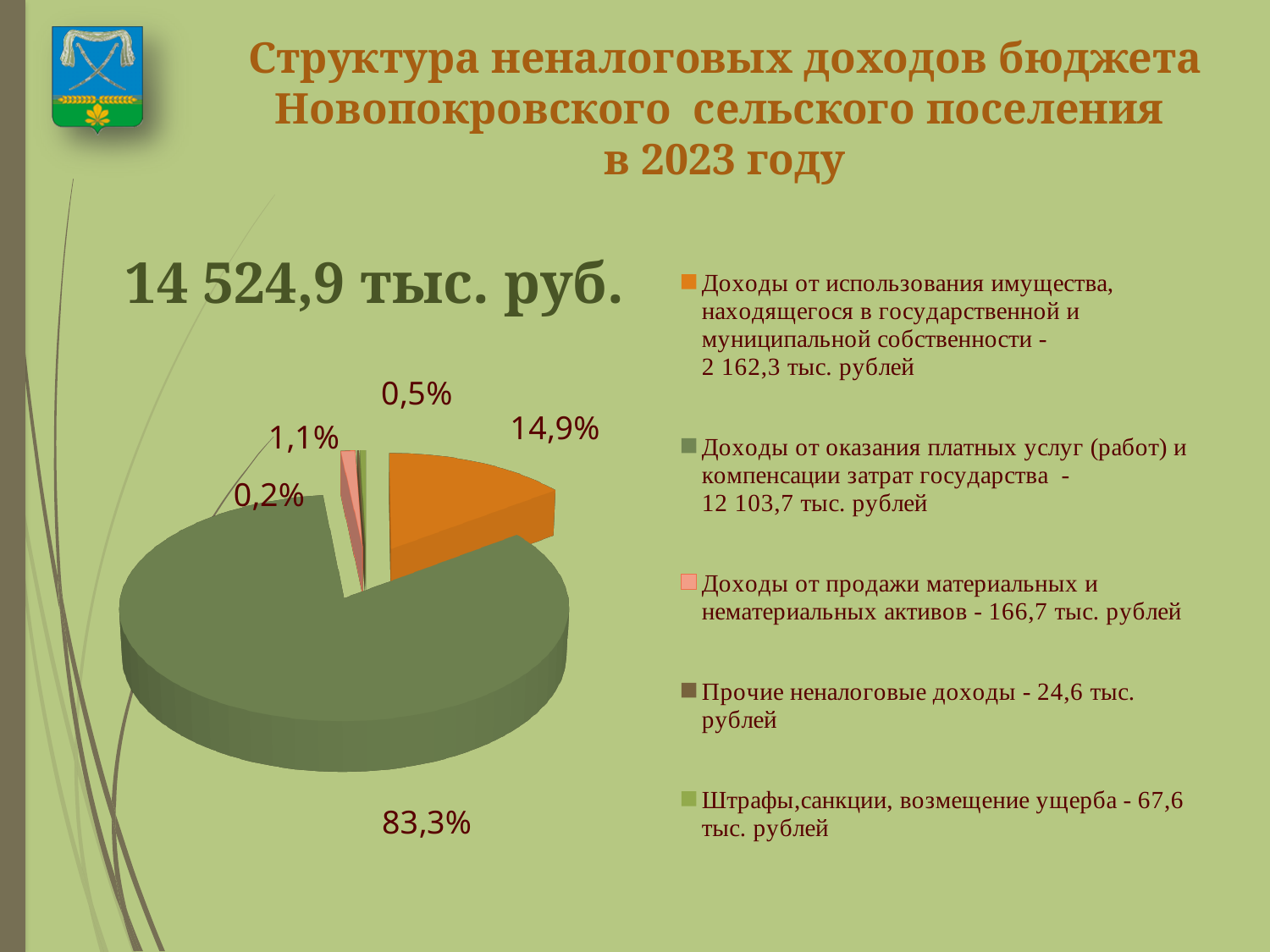
What total amount of non-tax income is shown above the pie chart? 14 524,9 тыс. руб. According to the legend, what is the amount of other non-tax income (Прочие неналоговые доходы)? 24,6 тыс. рублей Which category has the largest slice of the pie? Доходы от оказания платных услуг (работ) и компенсации затрат государства What share of the pie is labelled for fines, sanctions and damage compensation (Штрафы, санкции, возмещение ущерба)? 0,5% How many slices does the pie chart have? 5 What share of the pie is labelled for income from the use of state and municipal property (Доходы от использования имущества)? 14,9% What share of the pie is labelled for income from the sale of tangible and intangible assets (Доходы от продажи материальных и нематериальных активов)? 1,1% Which category has the smallest slice of the pie? Прочие неналоговые доходы What type of chart is shown on the slide? pie chart According to the legend, what is the amount of income from the use of state and municipal property? 2 162,3 тыс. рублей How many entries does the legend list? 5